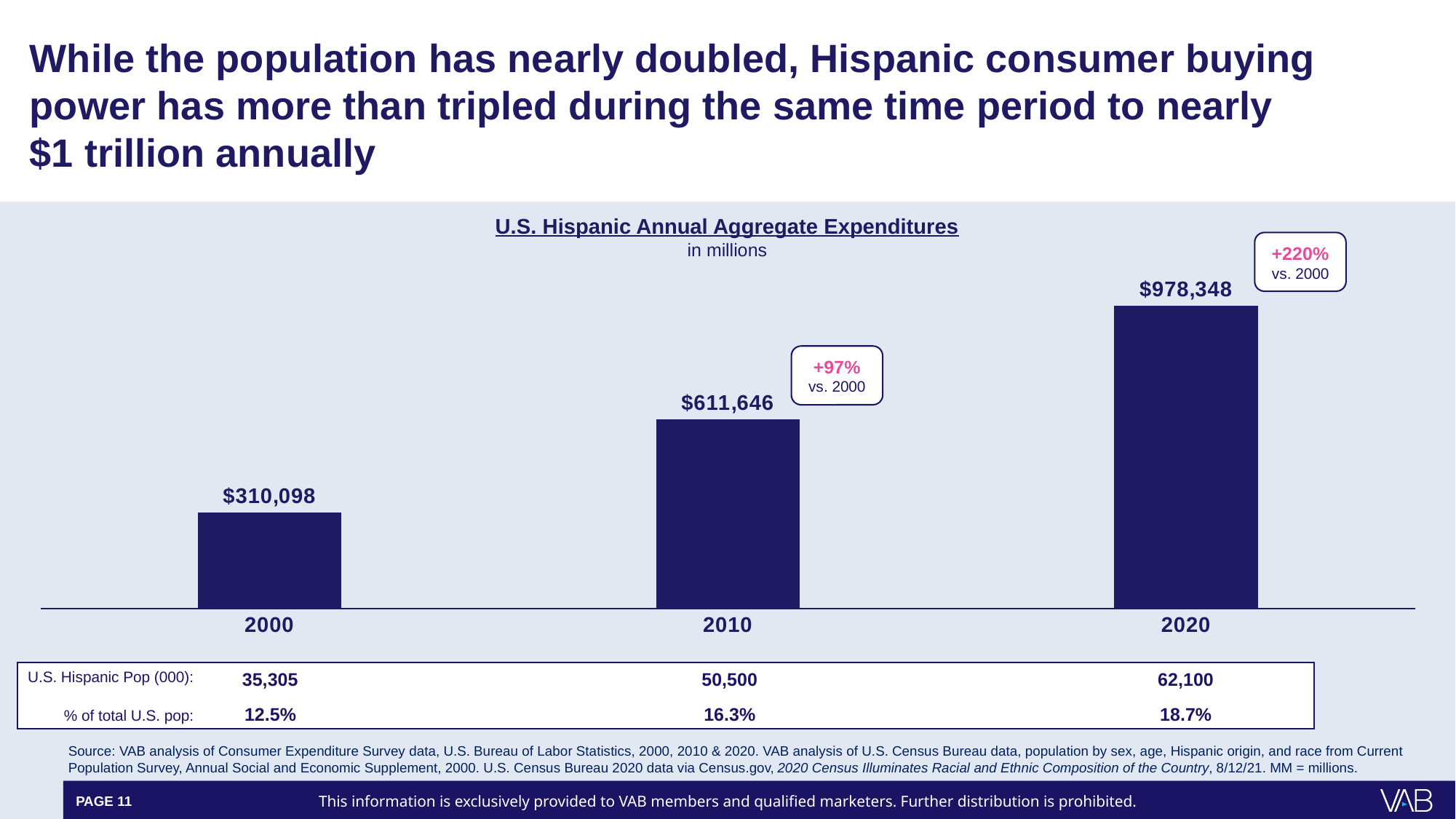
What is the value of U.S. Hispanic annual aggregate expenditures for 2010? $611,646 What kind of chart is used to show U.S. Hispanic Annual Aggregate Expenditures? Bar chart Which year has the highest U.S. Hispanic annual aggregate expenditures? 2020 Do U.S. Hispanic annual aggregate expenditures rise or fall from 2000 to 2020? Rise Which year has the lowest U.S. Hispanic annual aggregate expenditures? 2000 How many years are shown in the U.S. Hispanic Annual Aggregate Expenditures chart? 3 What is the value of U.S. Hispanic annual aggregate expenditures for 2000? $310,098 What is the difference in U.S. Hispanic annual aggregate expenditures between 2010 and 2000? $301,548 Which year has larger U.S. Hispanic annual aggregate expenditures, 2010 or 2020? 2020 What percentage change vs. 2000 is annotated on the 2020 bar? +220% What is the difference in U.S. Hispanic annual aggregate expenditures between 2020 and 2000? $668,250 What is the value of U.S. Hispanic annual aggregate expenditures for 2020? $978,348